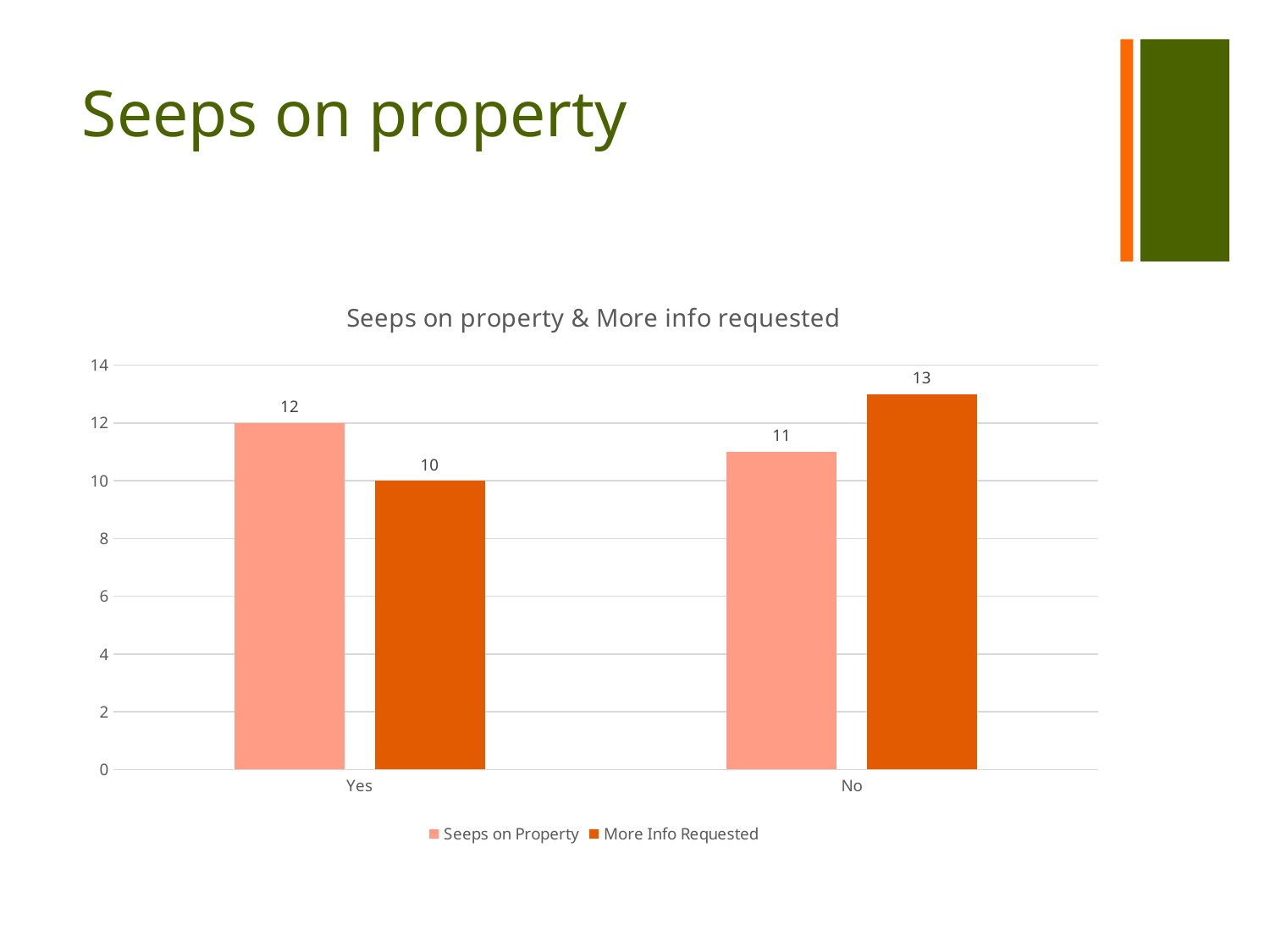
What is the title of the chart? Seeps on property & More info requested Which bar has the lowest value on the chart? More Info Requested, Yes What is the value for More Info Requested in the No category? 13 What kind of chart is shown on the slide? Bar chart What is the value for More Info Requested in the Yes category? 10 What is the value for Seeps on Property in the Yes category? 12 Which bar has the highest value on the chart? More Info Requested, No Which is larger in the Yes category: Seeps on Property or More Info Requested? Seeps on Property What is the value for Seeps on Property in the No category? 11 What is the difference between More Info Requested for No and More Info Requested for Yes? 3 How many series does the legend list? 2 How many categories are shown on the x axis? 2